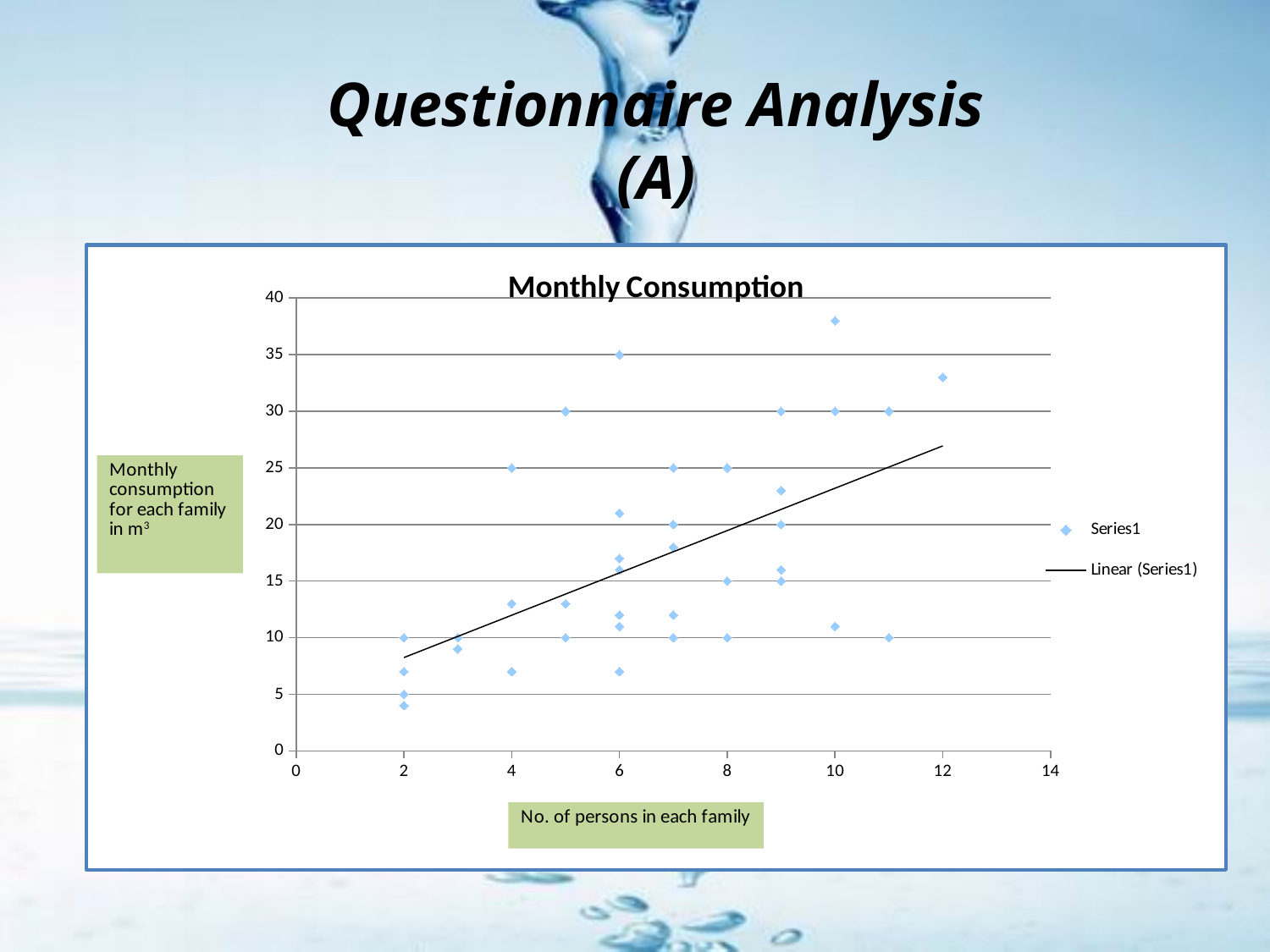
At what number of persons in each family does the highest monthly consumption point occur? 10 Are the monthly consumption values for families with 3 persons greater or less than 15? less What does the x axis of the chart represent? No. of persons in each family Does the linear trendline rise or fall as the number of persons in each family increases? Rises What kind of chart is shown on the slide? Scatter chart How many entries does the chart legend list? 2 Is the monthly consumption value for the family with 12 persons greater or less than 30? greater What is the title of the chart? Monthly Consumption Is the highest monthly consumption value for families with 10 persons greater or less than 35? greater At what number of persons in each family does the lowest monthly consumption point occur? 2 Which is larger: the highest monthly consumption point for families with 10 persons or the point for families with 12 persons? 10 persons What is the maximum value shown on the y axis of the chart? 40